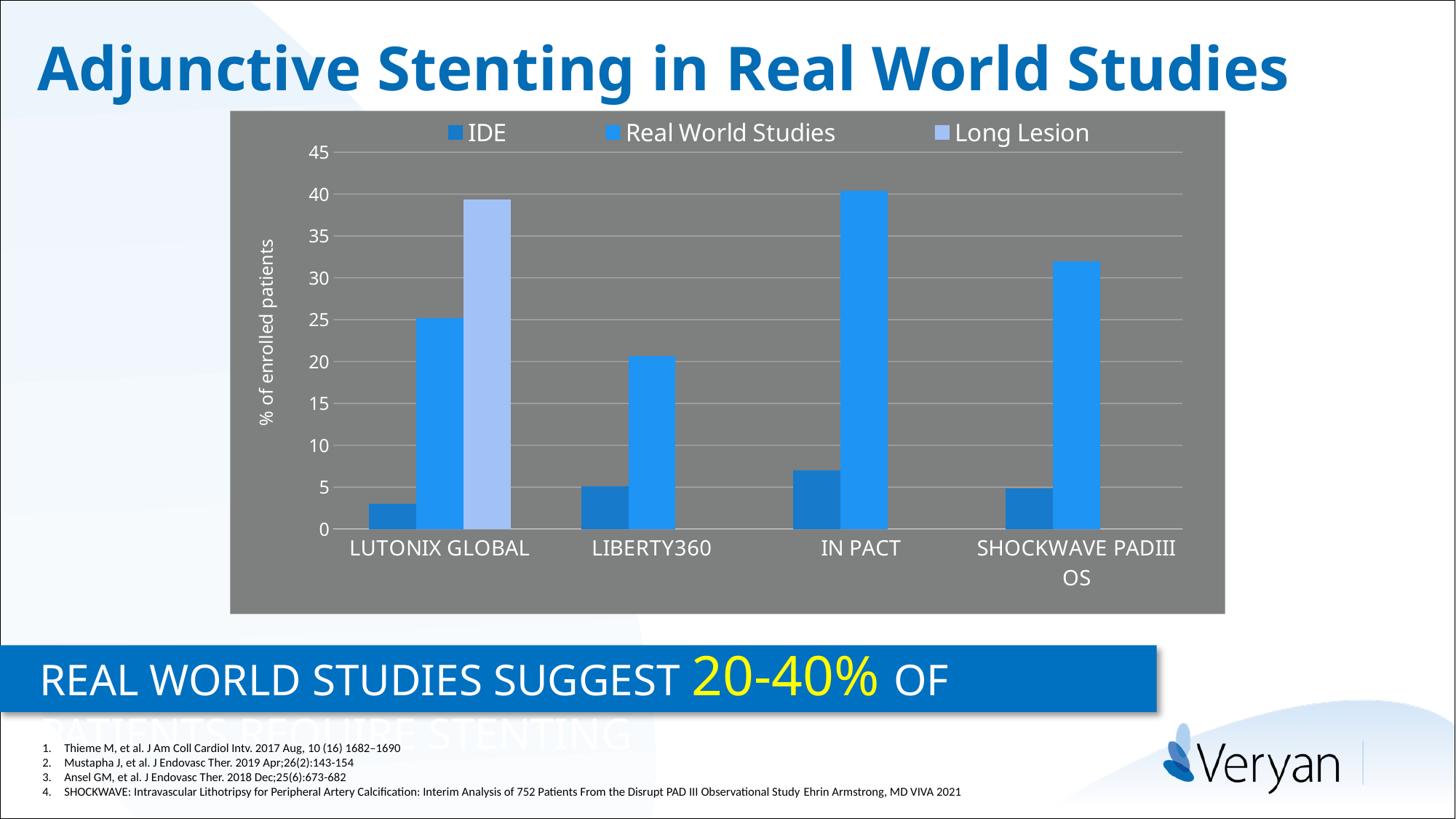
Which study has the lowest IDE value? LUTONIX GLOBAL Which study has the highest Real World Studies value? IN PACT Is the Real World Studies value for IN PACT greater or less than 35? greater Which study has the highest IDE value? IN PACT How many study categories are shown on the x axis? 4 How many series does the chart legend list? 3 Which study has the lowest Real World Studies value? LIBERTY360 Is the Real World Studies value for LIBERTY360 greater or less than 25? less What is the label on the y axis of the chart? % of enrolled patients Is the Long Lesion value for LUTONIX GLOBAL greater or less than 35? greater What kind of chart is shown on the slide? bar chart Which is larger, the Real World Studies value for LUTONIX GLOBAL or for SHOCKWAVE PADIII OS? SHOCKWAVE PADIII OS